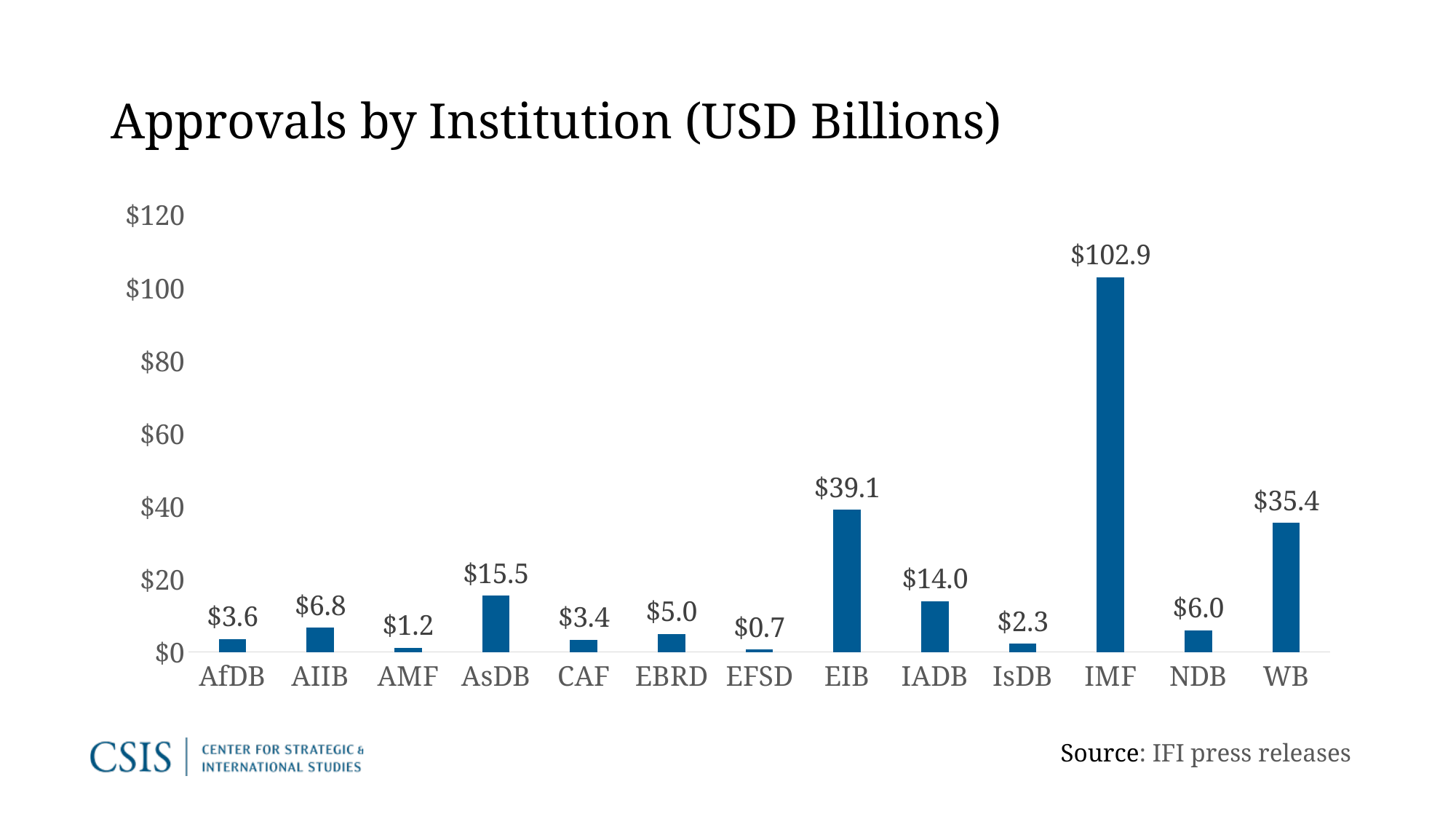
What is the difference between the values for EIB and IADB? $25.1 Which institution has the highest approvals? IMF Is the value for WB greater or less than $40? less What is the difference between the values for IMF and WB? $67.5 Which is larger, the value for AIIB or the value for NDB? AIIB What kind of chart is shown on the slide? bar chart Which institution has the lowest approvals? EFSD How many institutions are shown on the chart? 13 What is the value for EIB? $39.1 What is the value for AsDB? $15.5 What is the value for IMF? $102.9 What is the title of the chart? Approvals by Institution (USD Billions)